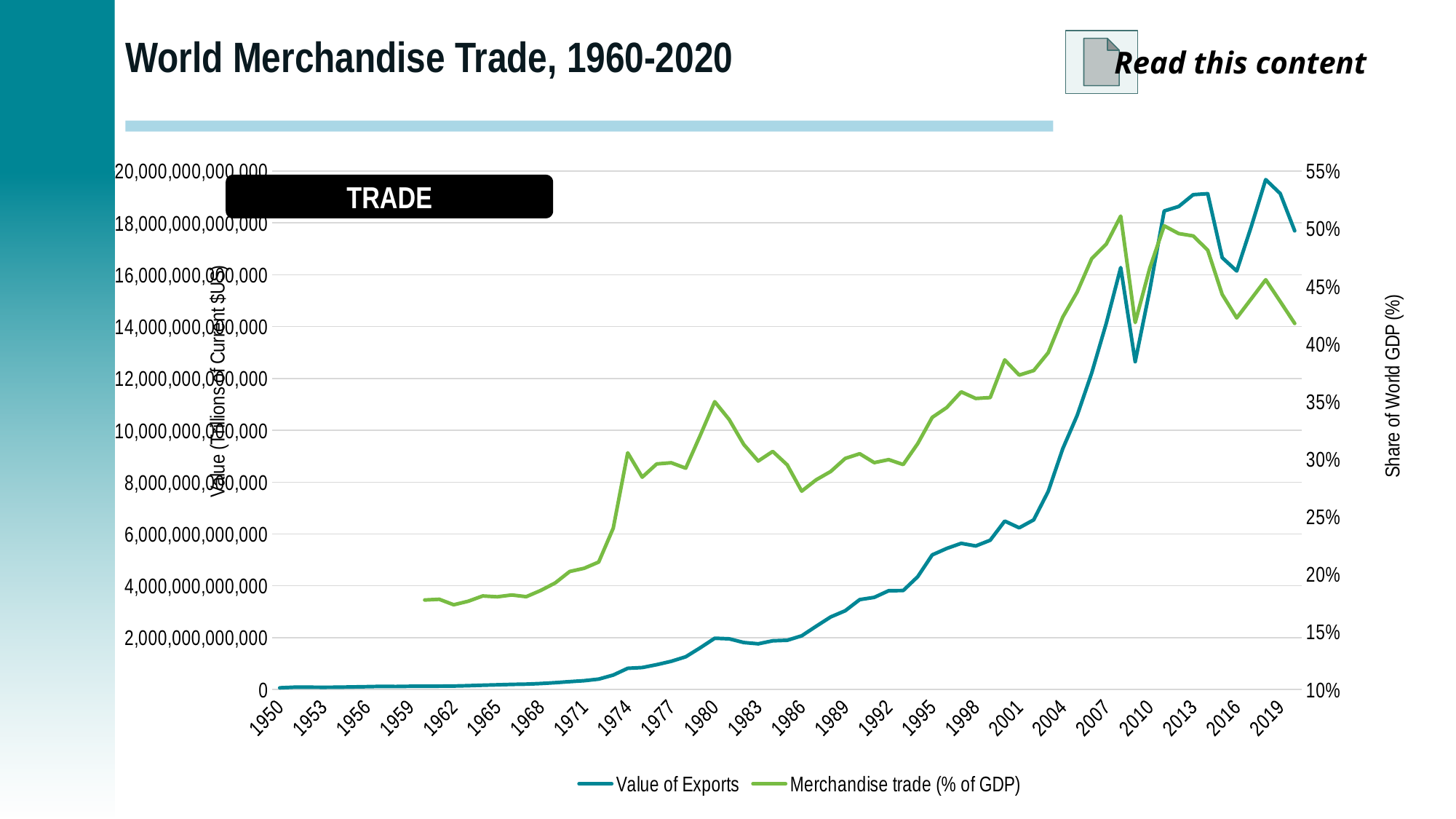
Is Merchandise trade (% of GDP) in 1986 greater or less than 30%? less What are the two series named in the legend? Value of Exports; Merchandise trade (% of GDP) Does Merchandise trade (% of GDP) rise or fall between 2019 and 2020? fall Is Merchandise trade (% of GDP) in 2020 greater or less than 45%? less Is the Value of Exports in 2016 greater or less than 14,000,000,000,000? greater How many series does the legend list? 2 What kind of chart is shown on the slide? Line chart Overall, does the Value of Exports rise or fall from 1950 to 2019? rise What is the title of the chart? World Merchandise Trade, 1960-2020